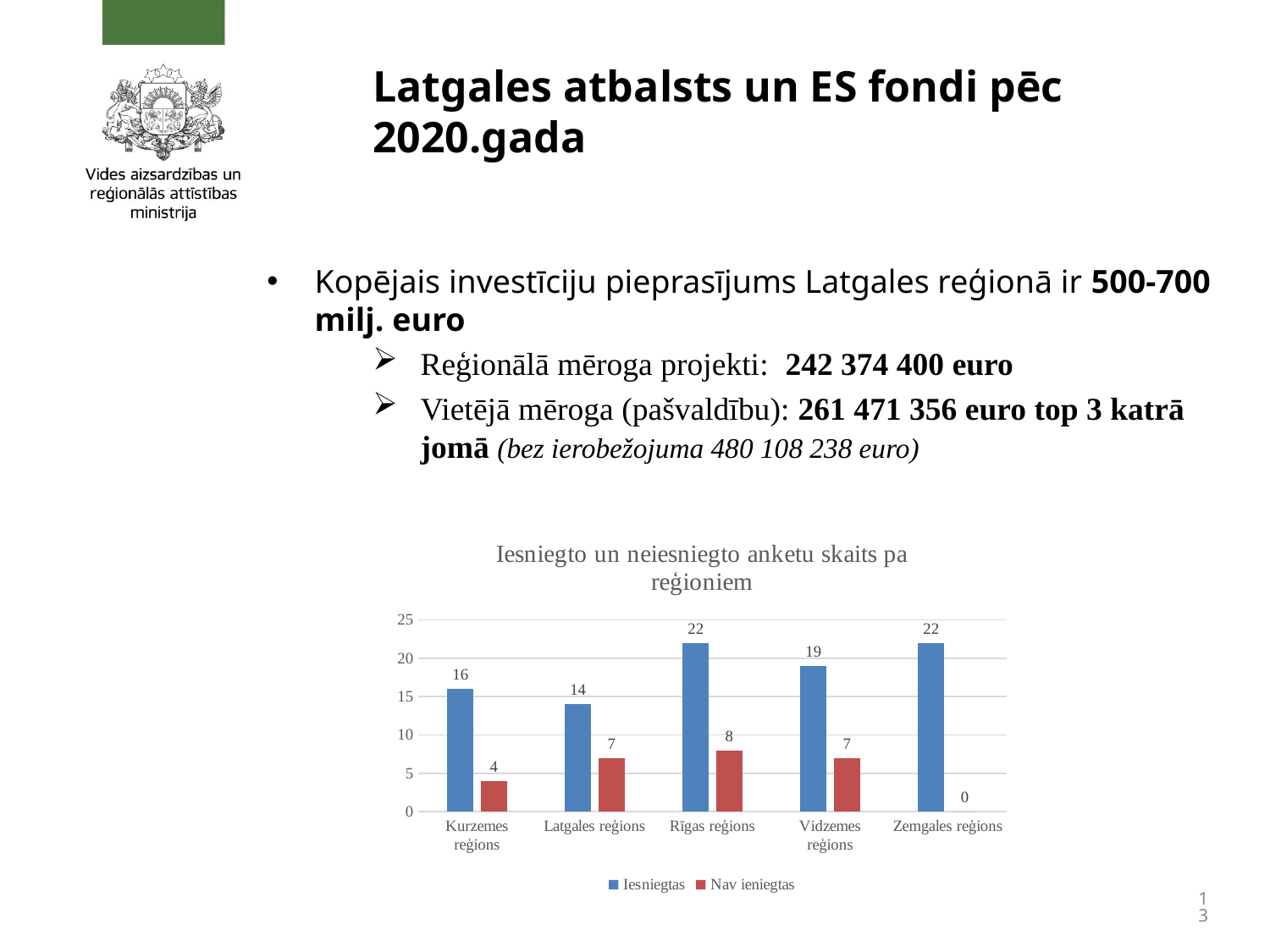
Which is larger: the Iesniegtas value for Kurzemes reģions or for Vidzemes reģions? Vidzemes reģions What type of chart is shown on the slide? Bar chart How many series does the chart legend list? 2 What is the Iesniegtas value for Latgales reģions? 14 What is the Nav ieniegtas value for Zemgales reģions? 0 How many regions are shown on the x axis of the chart? 5 What is the Nav ieniegtas value for Rīgas reģions? 8 What is the difference between the Iesniegtas and Nav ieniegtas values for Kurzemes reģions? 12 Which region has the lowest Iesniegtas value? Latgales reģions Which region has the highest Nav ieniegtas value? Rīgas reģions What is the title of the chart? Iesniegto un neiesniegto anketu skaits pa reģioniem What is the Iesniegtas value for Vidzemes reģions? 19